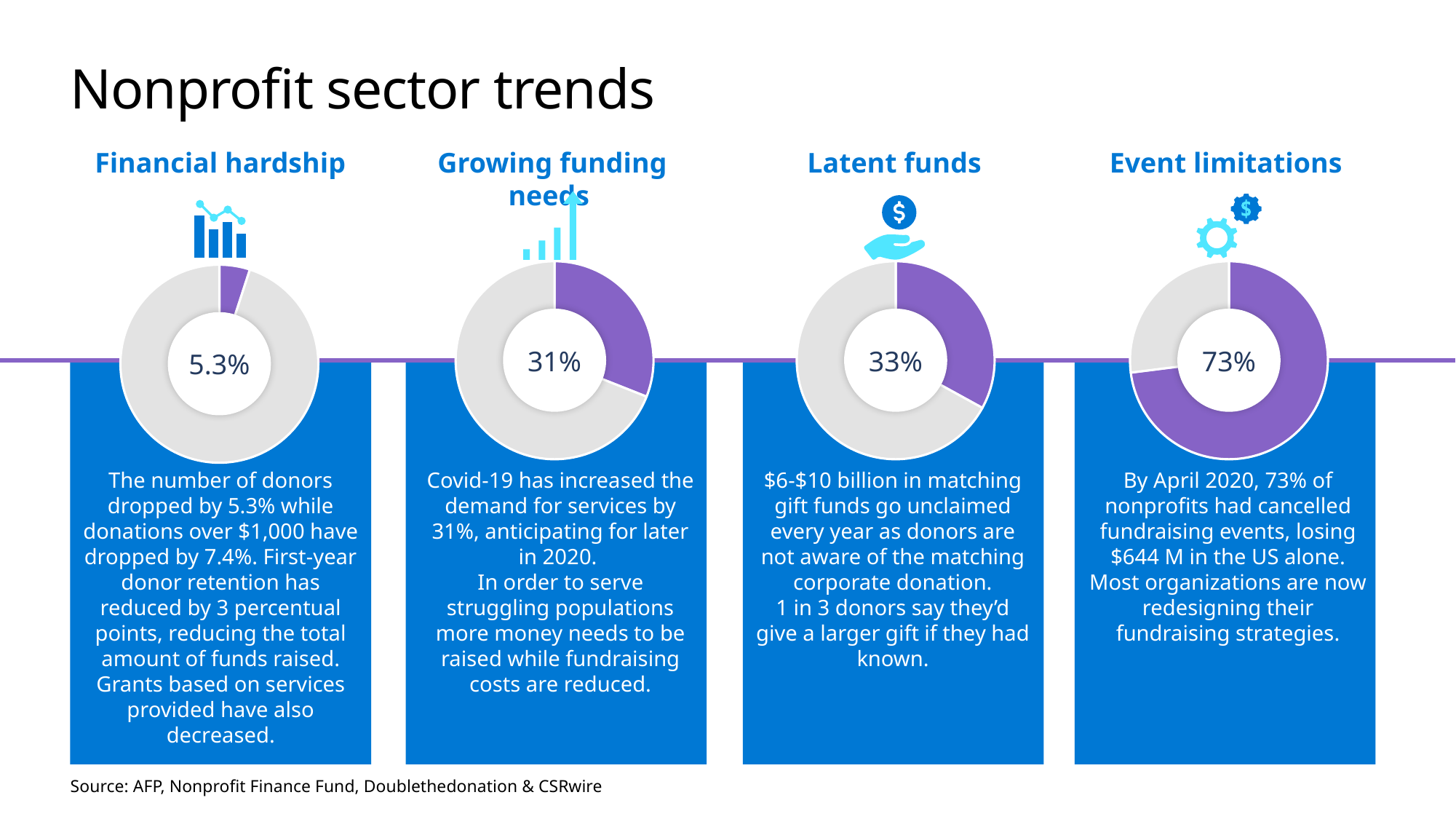
Which of the four donut charts shows the lowest percentage? Financial hardship Which donut chart shows a larger percentage, Latent funds or Growing funding needs? Latent funds What percentage is shown in the centre of the Latent funds donut chart? 33% What colour is the highlighted slice in each donut chart? Purple What percentage is shown in the centre of the Financial hardship donut chart? 5.3% What is the difference between the percentage in the Event limitations donut and the percentage in the Latent funds donut? 40% What kind of chart is used under each of the four headings on the slide? Donut (pie) chart What percentage is shown in the centre of the Event limitations donut chart? 73% In the Event limitations donut chart, what share of the ring is filled by the purple slice? 73% How many donut charts are on the slide? 4 Which of the four donut charts shows the highest percentage? Event limitations What percentage is shown in the centre of the Growing funding needs donut chart? 31%